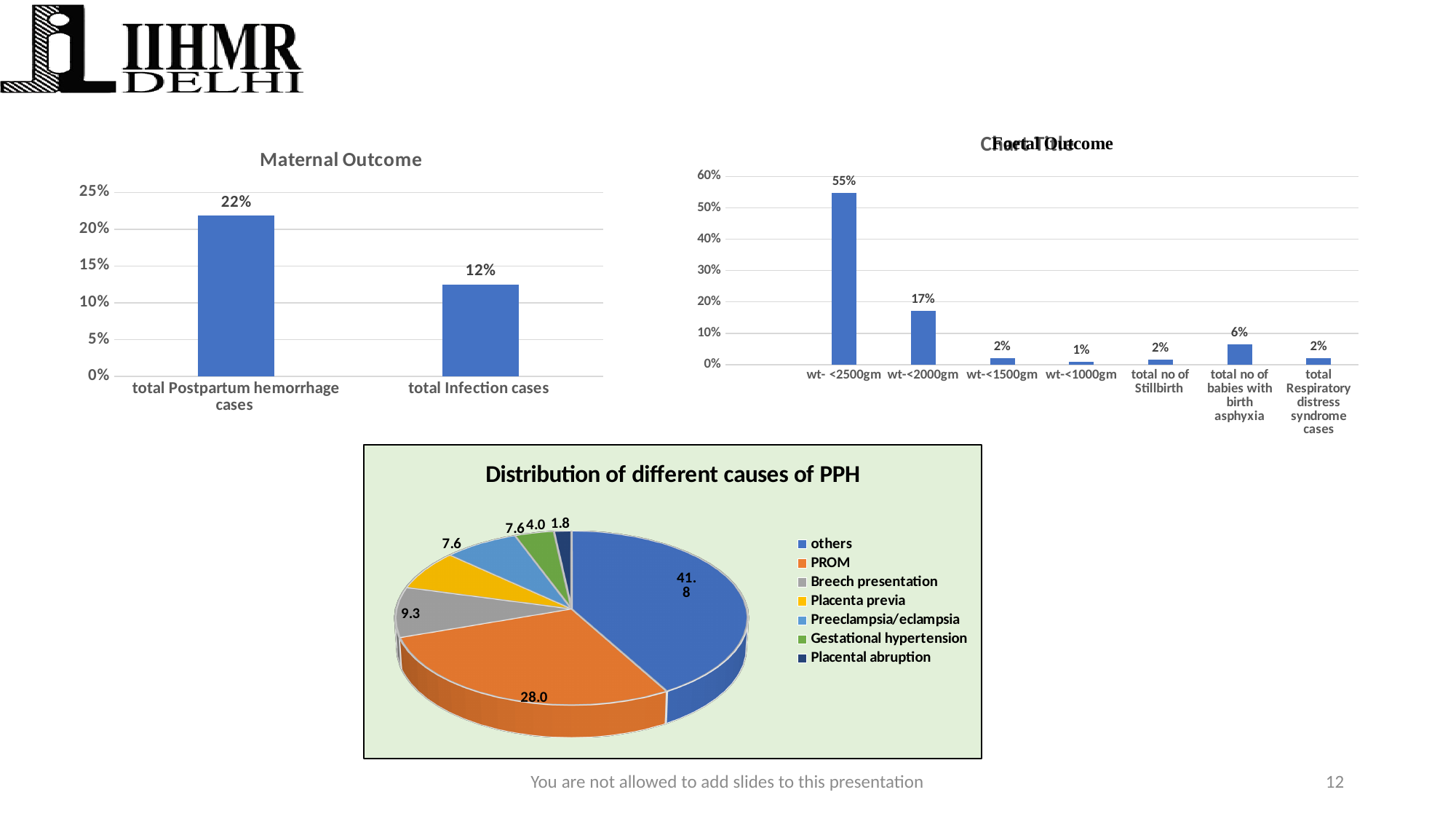
In the Foetal Outcome chart, what is the value for total no of babies with birth asphyxia? 6% In the Foetal Outcome chart, which category has the lowest value? wt-<1000gm In the Maternal Outcome chart, what is the difference between total Postpartum hemorrhage cases and total Infection cases? 10% In the Foetal Outcome chart, which is larger: wt-<2000gm or total no of Stillbirth? wt-<2000gm In the Distribution of different causes of PPH chart, which cause has the largest slice? others In the Maternal Outcome chart, what is the value for total Infection cases? 12% In the Foetal Outcome chart, how many categories are plotted? 7 In the Distribution of different causes of PPH chart, what is the value for PROM? 28.0 In the Foetal Outcome chart, what is the value for wt- <2500gm? 55% In the Maternal Outcome chart, what is the value for total Postpartum hemorrhage cases? 22% In the Maternal Outcome chart, how many categories are plotted? 2 What kind of chart is the Distribution of different causes of PPH chart? pie chart